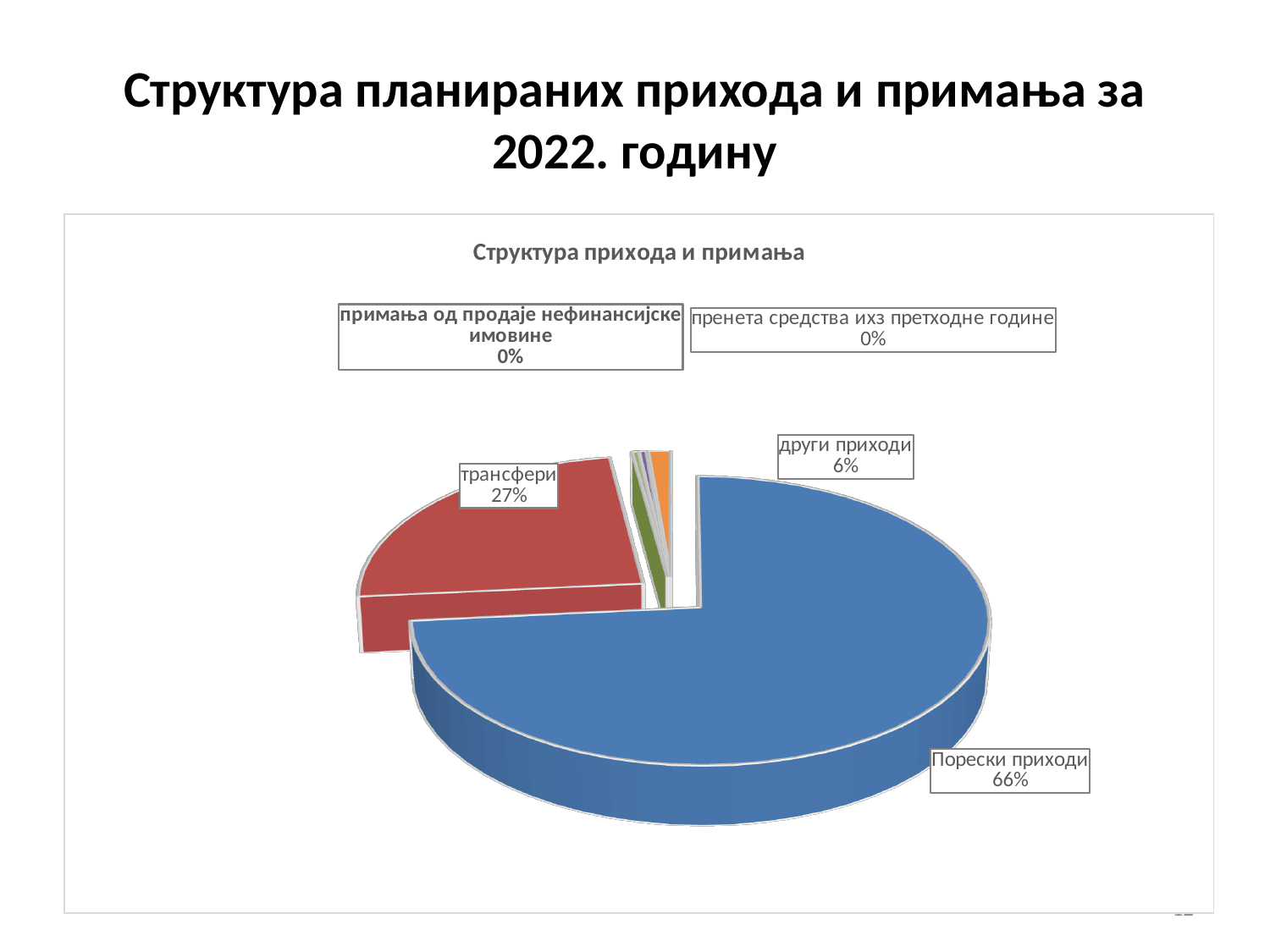
What is the difference in percentage points between трансфери and други приходи? 21 What is the title of the chart? Структура прихода и примања What is the value shown for пренета средства ихз претходне године? 0% How many categories are labelled on the pie chart? 5 Which category has the largest share of the pie? Порески приходи Which is larger, the share for трансфери or the share for други приходи? трансфери What is the difference in percentage points between Порески приходи and трансфери? 39 What is the value shown for трансфери? 27% What kind of chart is shown on the slide? pie chart What is the value shown for други приходи? 6% What is the value shown for примања од продаје нефинансијске имовине? 0% What share of the pie does Порески приходи take? 66%